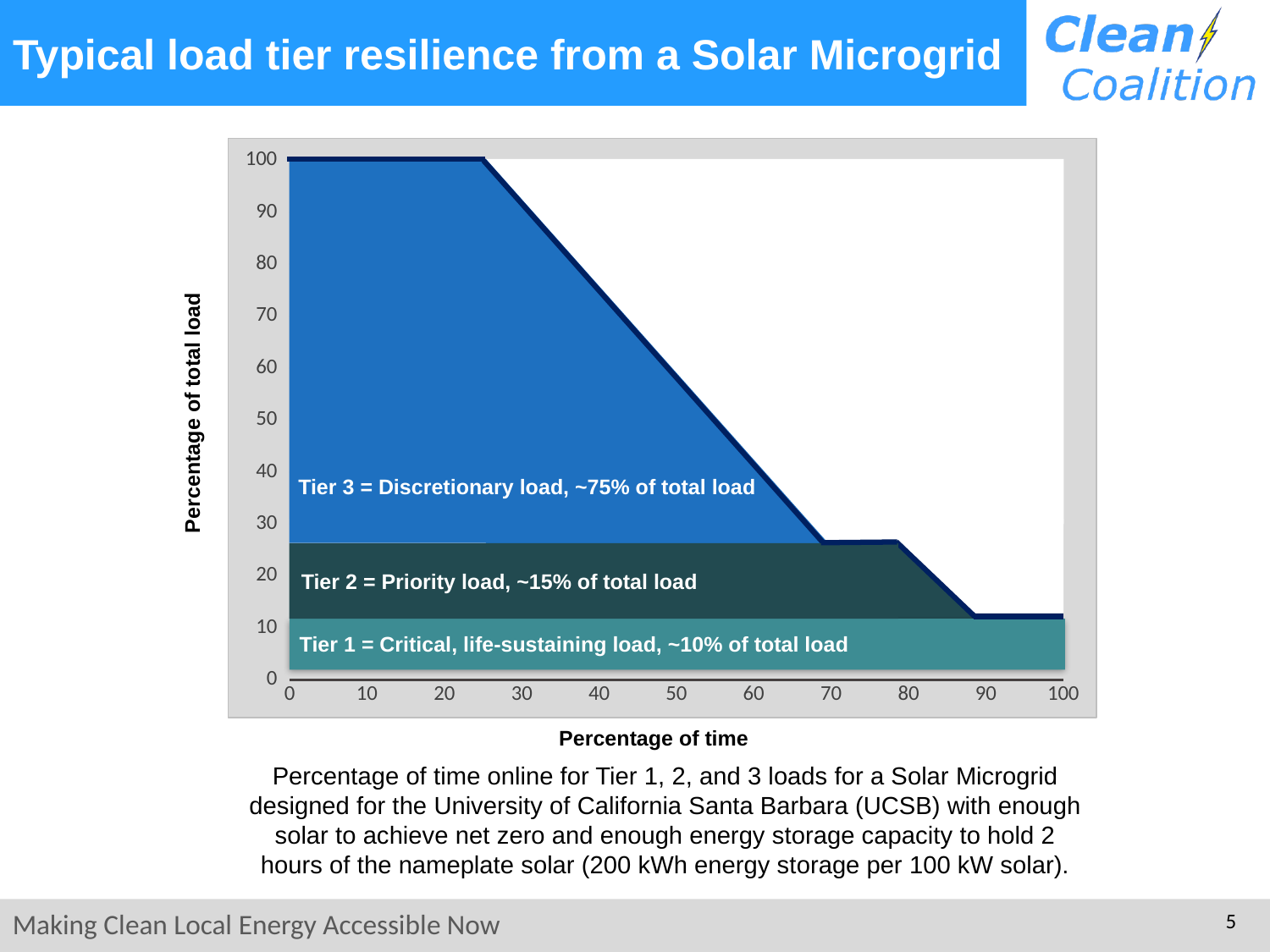
What is the title of the x axis? Percentage of time How many load tiers are labelled on the chart? 3 According to the chart label, what share of total load is Tier 3 (Discretionary load)? ~75% of total load Is the percentage of total load served at 90% of time greater or less than 20? less What kind of chart is shown on the slide? Area chart According to the chart label, what share of total load is Tier 1 (Critical, life-sustaining load)? ~10% of total load Is the percentage of total load served at 60% of time greater or less than 50? less Is the percentage of total load served at 50% of time greater or less than 50? greater According to the chart label, what share of total load is Tier 2 (Priority load)? ~15% of total load What percentage of total load is served at 0% of time? 100 What is the title of the y axis? Percentage of total load Does the percentage of total load served rise or fall as the percentage of time increases? Fall